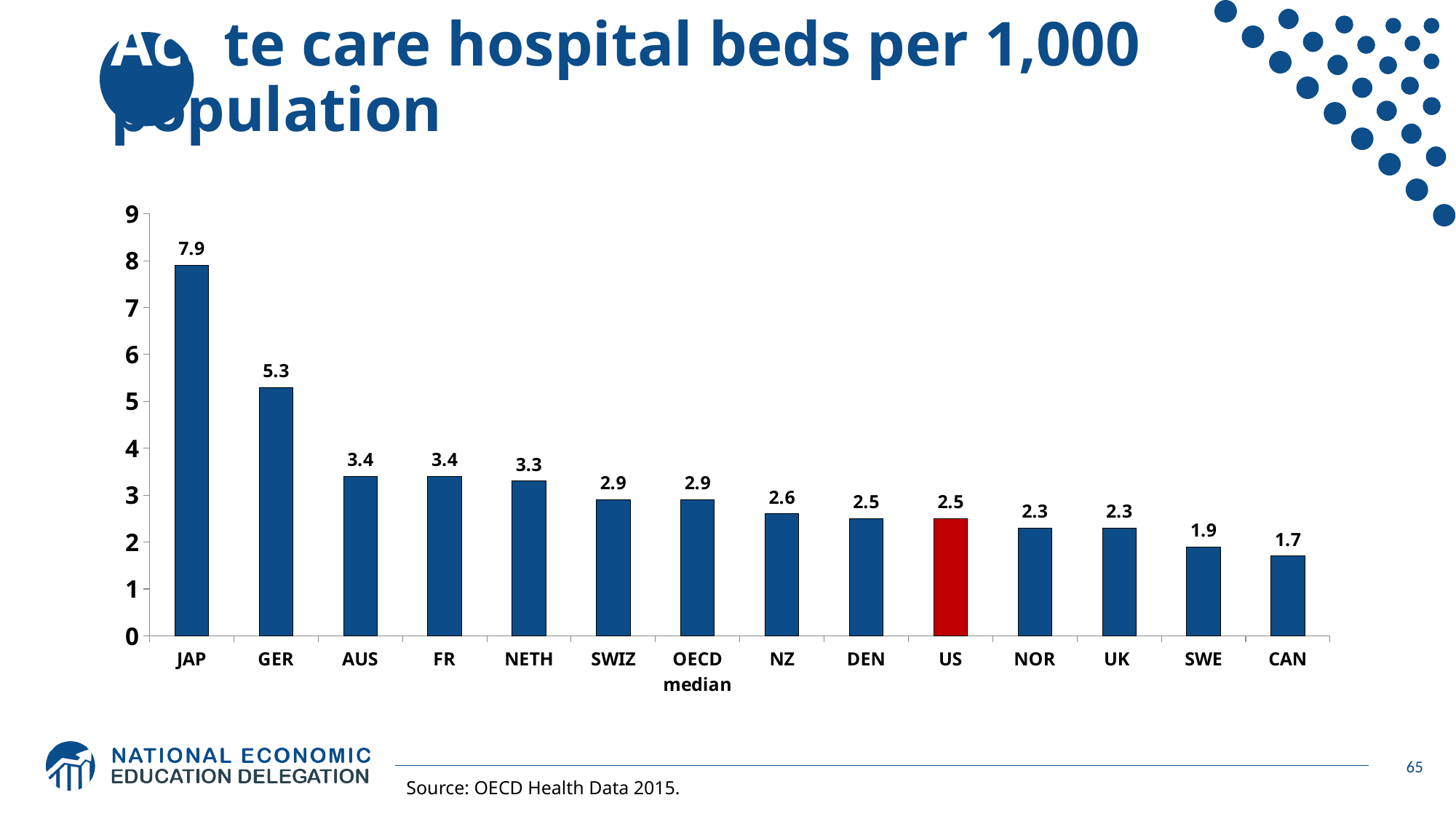
Which country has the highest number of acute care hospital beds per 1,000 population? JAP What kind of chart is shown on the slide? Bar chart What is the value for JAP? 7.9 What is the value for the OECD median? 2.9 Which is larger, the value for NETH or the value for SWIZ? NETH Which bar is coloured red rather than blue? US What is the difference between the values for JAP and GER? 2.6 How many bars are shown in the chart? 14 Is the value for GER greater or less than 5? greater Which country has the lowest number of acute care hospital beds per 1,000 population? CAN What is the difference between the values for the OECD median and the US? 0.4 What is the value for the US? 2.5